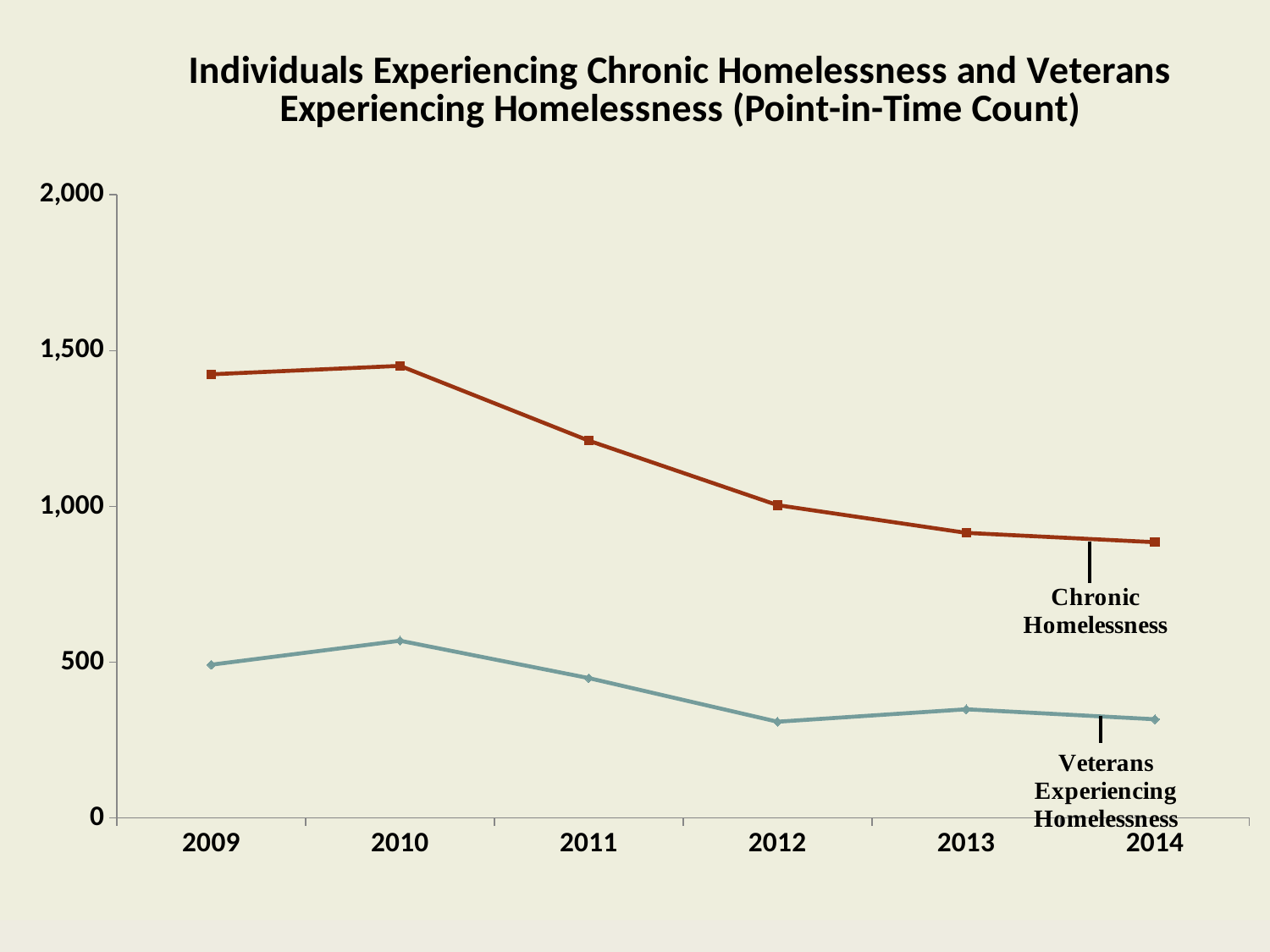
What kind of chart is shown on the slide? line chart Is the value for Chronic Homelessness in 2009 greater or less than 1,000? greater Is the value for Chronic Homelessness in 2014 greater or less than 1,000? less Is the value for Veterans Experiencing Homelessness in 2012 greater or less than 500? less In which year is the Veterans Experiencing Homelessness series at its highest? 2010 What is the title of the chart? Individuals Experiencing Chronic Homelessness and Veterans Experiencing Homelessness (Point-in-Time Count) How many series are plotted on the chart? 2 Which series has the larger value in 2013, Chronic Homelessness or Veterans Experiencing Homelessness? Chronic Homelessness Does the Chronic Homelessness series rise or fall from 2010 to 2014? fall How many years are shown along the x axis? 6